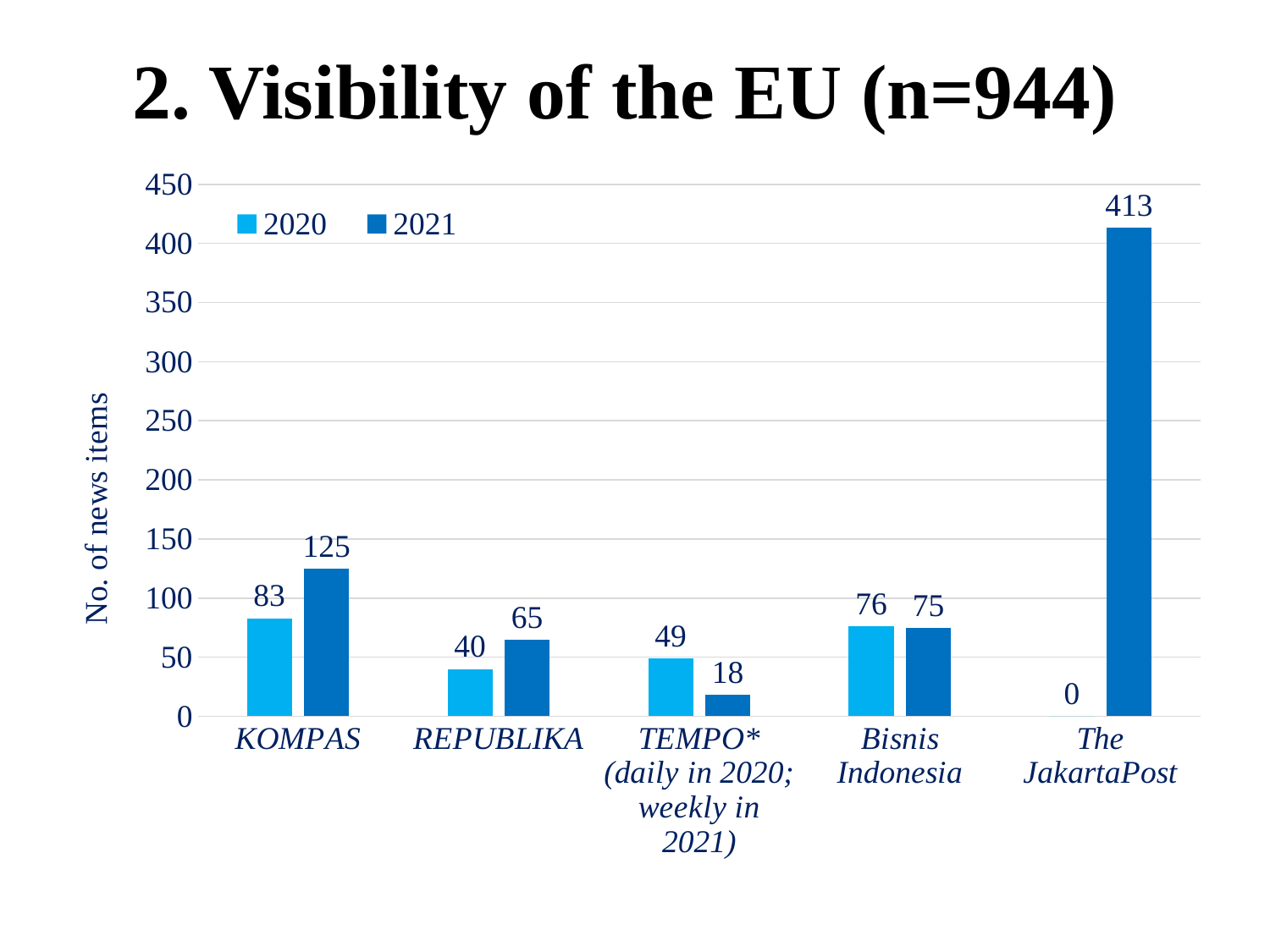
How many outlets (categories) are shown on the x axis? 5 Which outlet has the lowest 2020 value? The JakartaPost What is the difference between the 2021 and 2020 values for KOMPAS? 42 What kind of chart is shown on the slide? Bar chart Which is larger for TEMPO*: the 2020 value or the 2021 value? 2020 What is the 2021 value for KOMPAS? 125 What is the 2020 value for TEMPO*? 49 Which outlet has the highest 2021 value? The JakartaPost What is the label of the y axis? No. of news items How many series does the legend list? 2 What is the 2021 value for The JakartaPost? 413 What is the 2020 value for REPUBLIKA? 40